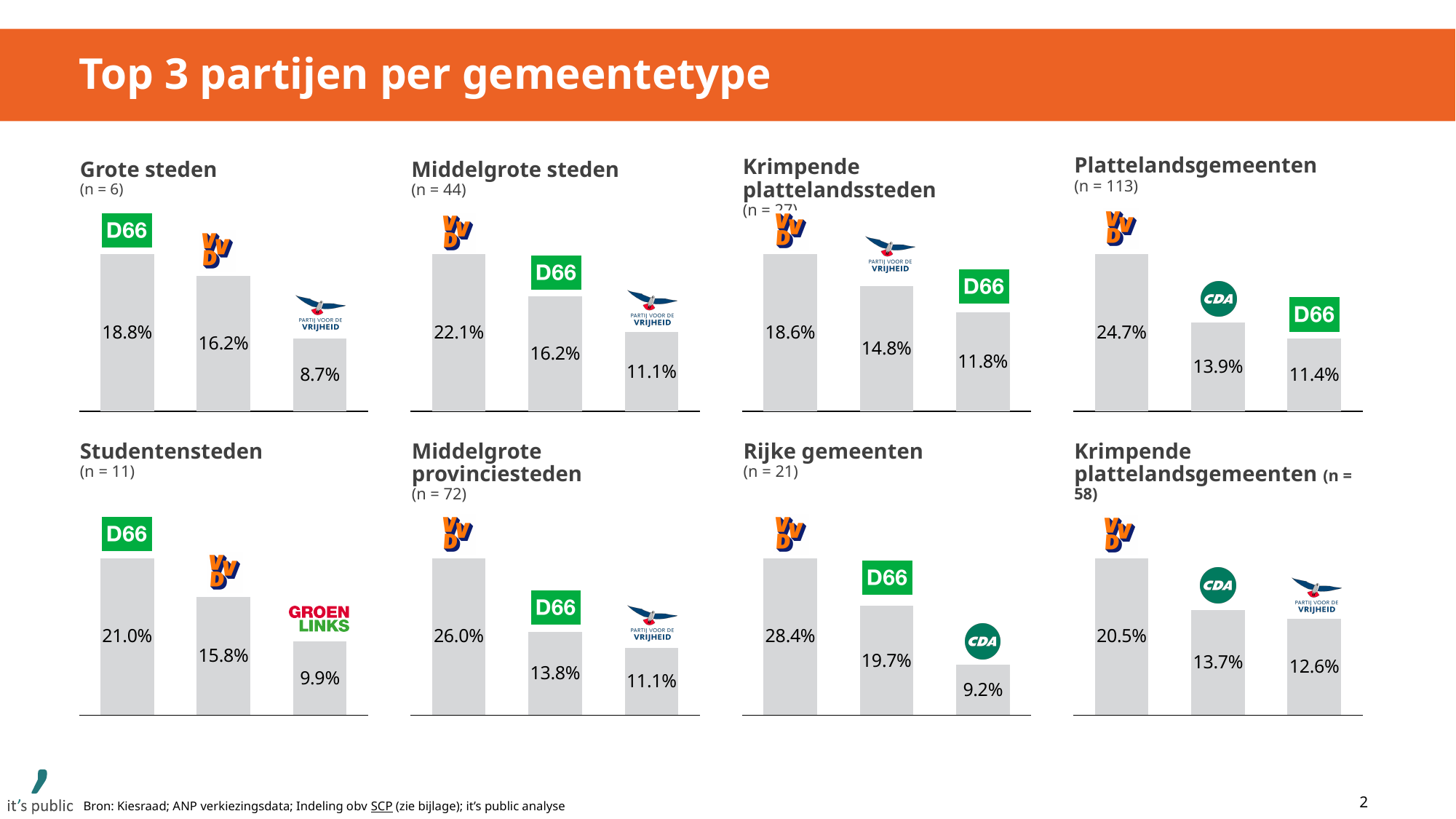
In the 'Middelgrote provinciesteden' chart, which party has the highest value? VVD In the 'Studentensteden' chart, which party has the lowest value? GroenLinks In the 'Plattelandsgemeenten' chart, what is the value for CDA? 13.9% In the 'Krimpende plattelandssteden' chart, which is larger: the value for Partij voor de Vrijheid or the value for D66? Partij voor de Vrijheid What kind of chart is used for 'Rijke gemeenten'? Bar chart In the 'Rijke gemeenten' chart, what is the value for VVD? 28.4% In the 'Middelgrote steden' chart, what is the difference between the VVD value and the D66 value? 5.9% In the 'Krimpende plattelandsgemeenten' chart, what is the value for Partij voor de Vrijheid? 12.6% In the 'Studentensteden' chart, do the values rise or fall from left to right? Fall In the 'Grote steden' chart, what is the value for D66? 18.8% How many bars are shown in the 'Krimpende plattelandsgemeenten' chart? 3 How many charts are shown on the slide? 8